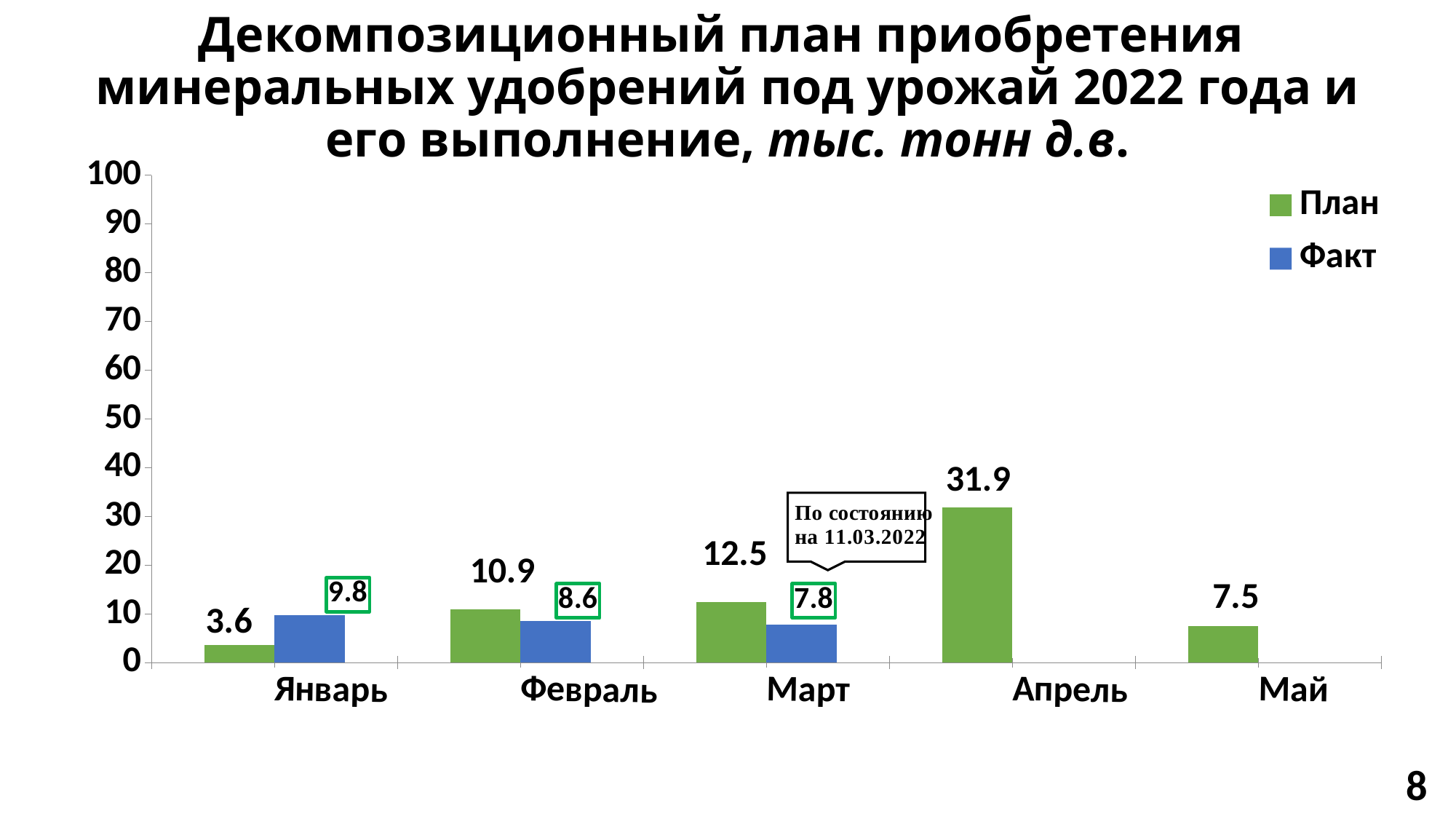
How many months are shown on the x axis? 5 Which is larger for Январь, the План value or the Факт value? Факт What date does the callout on the chart refer to? 11.03.2022 What is the План value for Апрель? 31.9 What is the План value for Февраль? 10.9 What is the Факт value for Январь? 9.8 What is the difference between the План and Факт values for Февраль? 2.3 Which month has the lowest План value? Январь What kind of chart is shown on the slide? Bar chart How many series does the legend list? 2 Which month has the highest План value? Апрель What is the Факт value for Март? 7.8